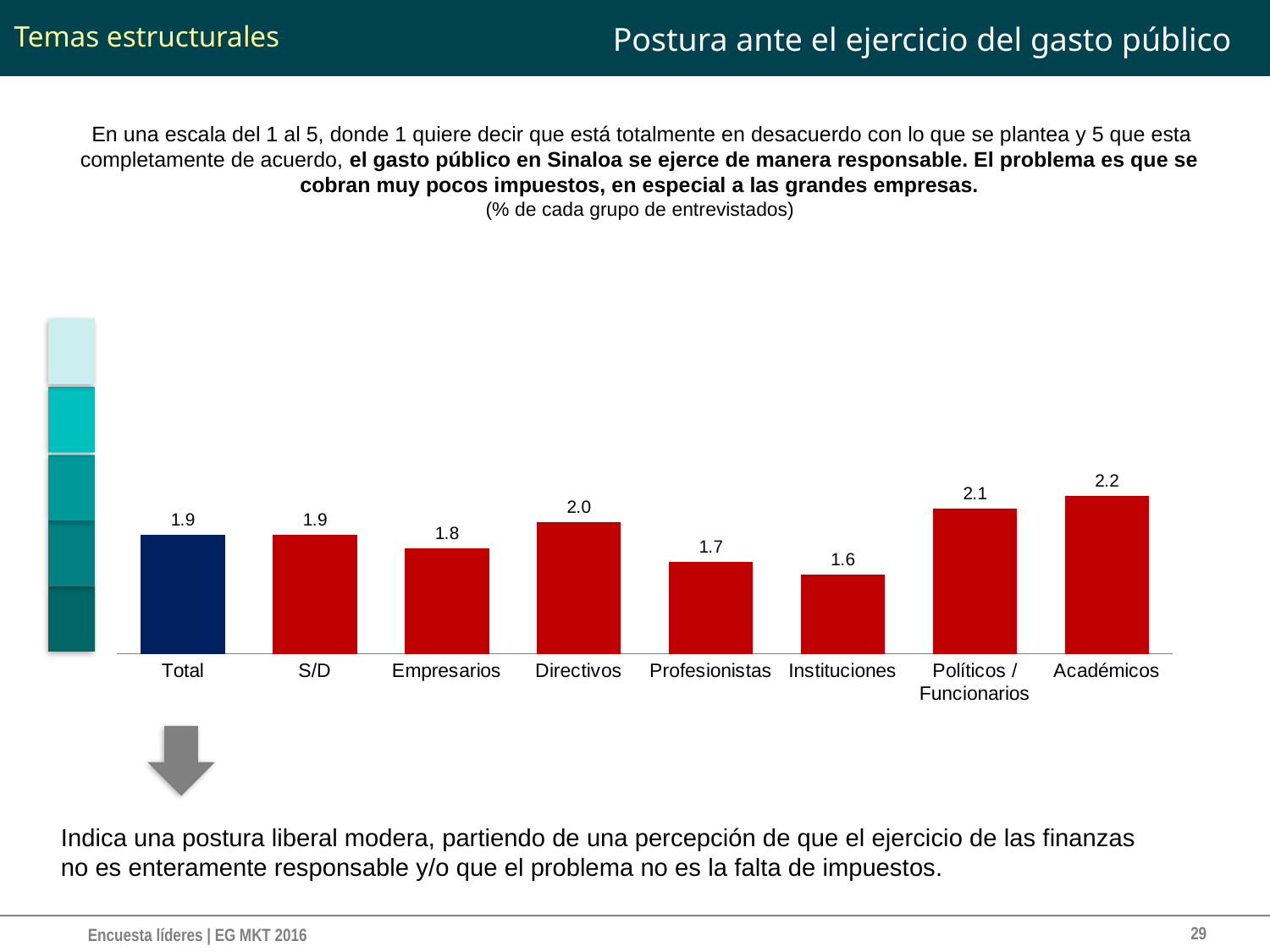
What is the value for Académicos? 2.2 Which bar is shown in a different colour (dark blue) from the others? Total What is the value for Instituciones? 1.6 What is the difference between the values for Académicos and Instituciones? 0.6 What is the difference between the values for Políticos / Funcionarios and Profesionistas? 0.4 What is the value for Directivos? 2.0 How many categories are shown on the x axis? 8 What kind of chart is shown on the slide? Bar chart Which category has the lowest value? Instituciones Which category has the highest value? Académicos What is the value for the Total bar? 1.9 Which is larger, the value for Empresarios or the value for Directivos? Directivos